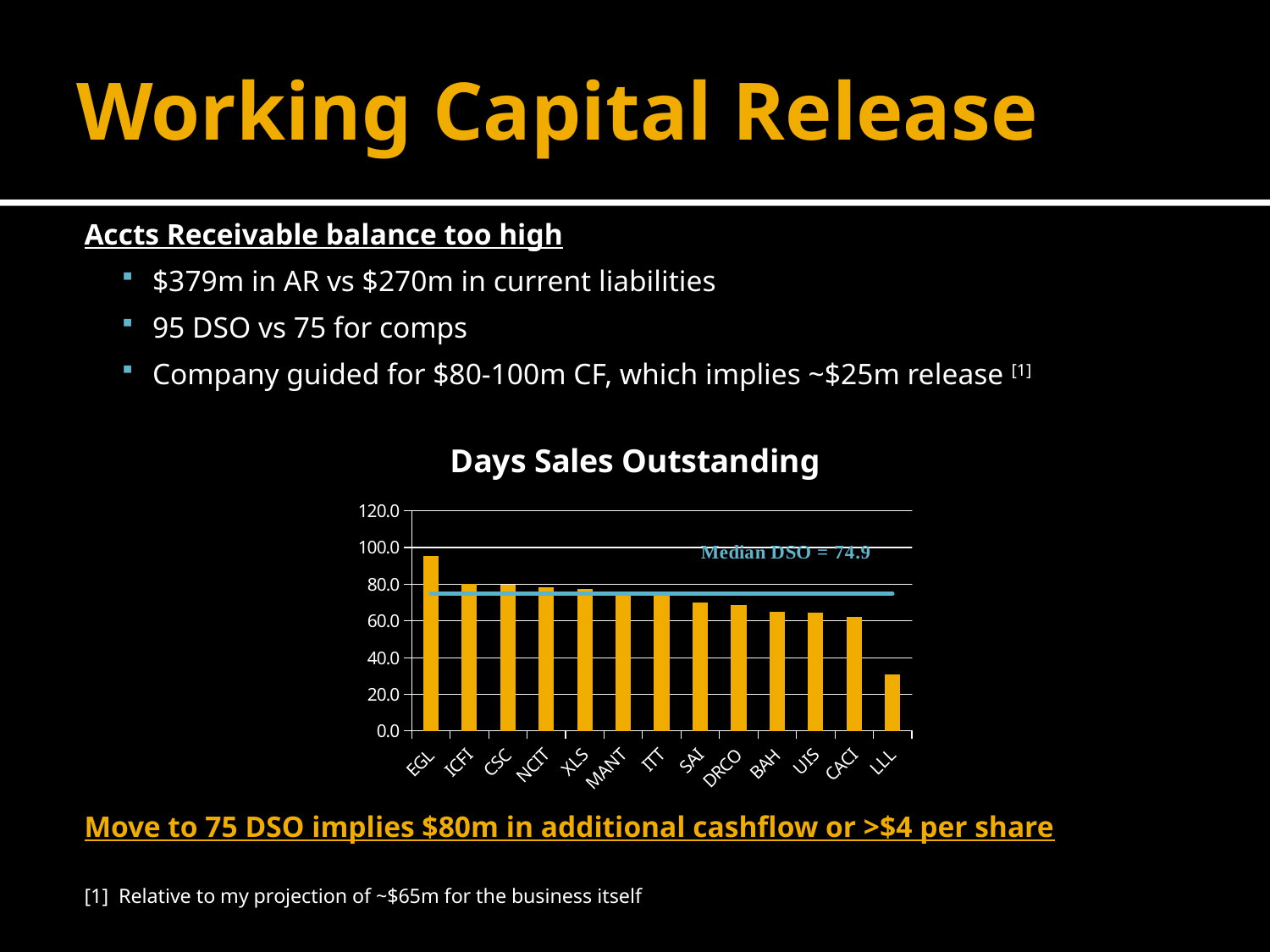
Which company has the highest Days Sales Outstanding? EGL What kind of chart is the Days Sales Outstanding chart? bar chart Is the Days Sales Outstanding value for EGL greater or less than 80? greater Do the bars in the Days Sales Outstanding chart rise or fall from left to right? fall Is the Days Sales Outstanding value for CACI greater or less than 80? less What median DSO value is labelled on the horizontal line in the chart? 74.9 Which has a higher Days Sales Outstanding, LLL or BAH? BAH Is the Days Sales Outstanding value for LLL greater or less than 40? less Which has a higher Days Sales Outstanding, ICFI or CACI? ICFI Which company has the lowest Days Sales Outstanding? LLL How many companies are shown on the x axis of the Days Sales Outstanding chart? 13